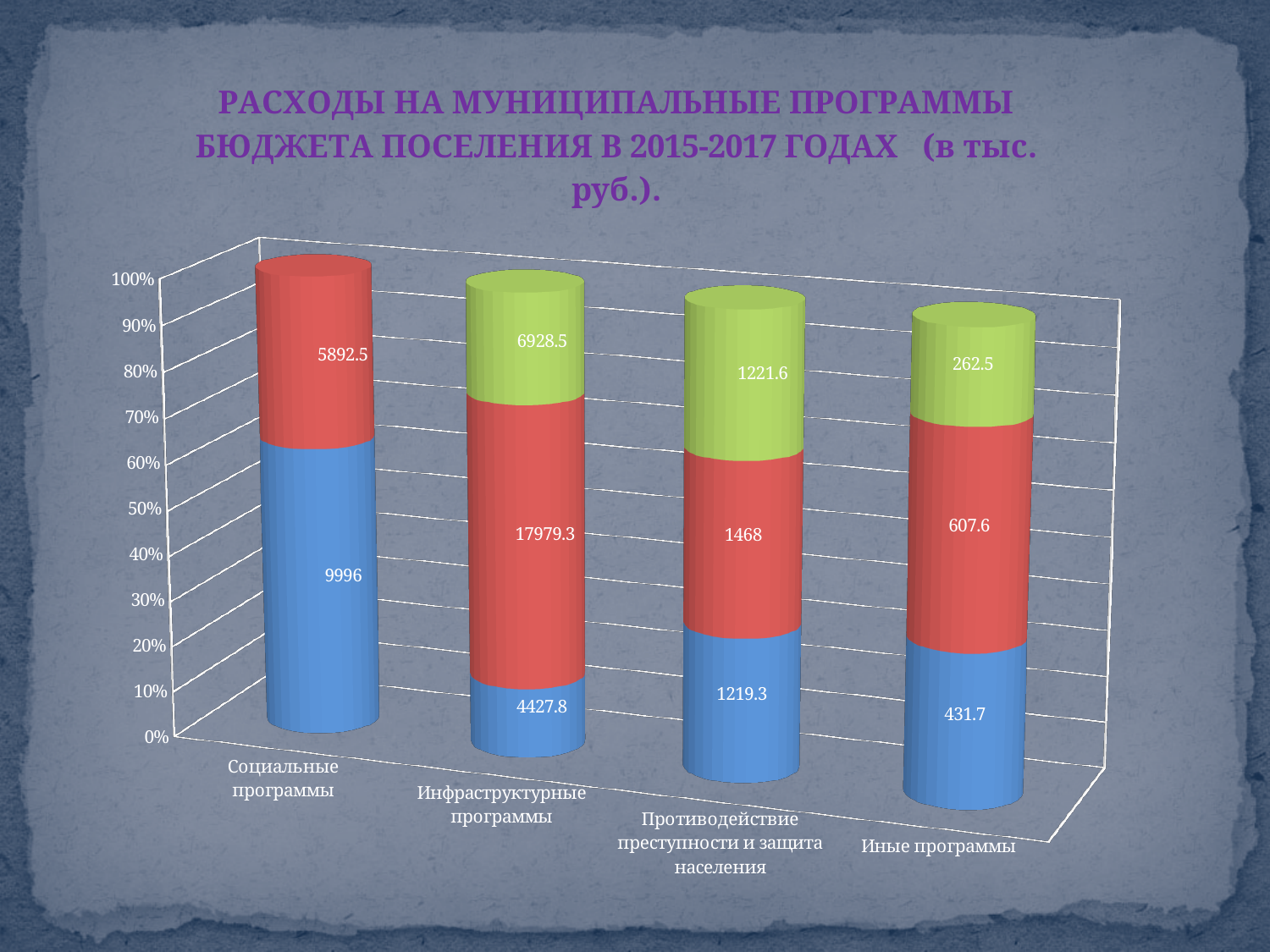
What kind of chart is shown on the slide? stacked bar chart Which category has the largest blue segment value? Социальные программы How many categories are shown on the x axis? 4 Is the blue segment for Социальные программы greater or less than 50% of the bar? greater What is the value of the red segment for Инфраструктурные программы? 17979.3 What is the value of the green segment for Иные программы? 262.5 What is the value of the blue segment for Социальные программы? 9996 Which category has the smallest red segment value? Иные программы What is the difference between the red and blue segment values for Инфраструктурные программы? 13551.5 What is the total of the values in the bar for Иные программы? 1301.8 What is the value of the blue segment for Противодействие преступности и защита населения? 1219.3 Which is larger for Противодействие преступности и защита населения: the red segment or the blue segment? the red segment